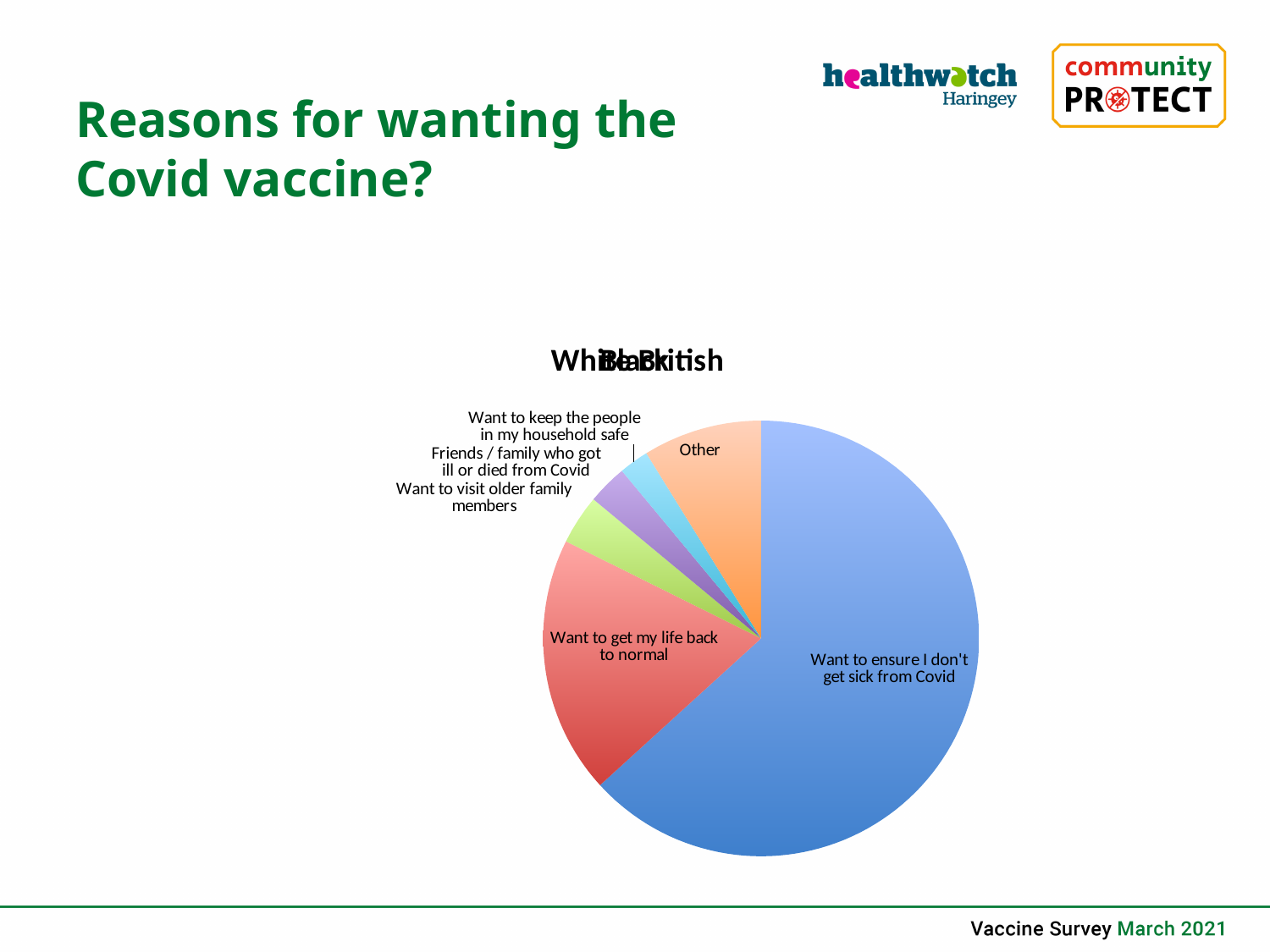
How many slices does the pie chart have? 6 Which reason has the second-largest slice of the pie chart? Want to get my life back to normal Which reason has the smallest slice of the pie chart? Want to keep the people in my household safe Does the slice for 'Want to ensure I don't get sick from Covid' take up more or less than half of the pie? more What kind of chart is shown on the slide? pie chart Which reason has the largest slice of the pie chart? Want to ensure I don't get sick from Covid Which slice is larger: 'Other' or 'Want to visit older family members'? Other What colour is the 'Other' slice of the pie chart? orange Which slice is larger: 'Want to ensure I don't get sick from Covid' or 'Want to get my life back to normal'? Want to ensure I don't get sick from Covid What colour is the largest slice of the pie chart? blue Which slice is larger: 'Want to get my life back to normal' or 'Other'? Want to get my life back to normal